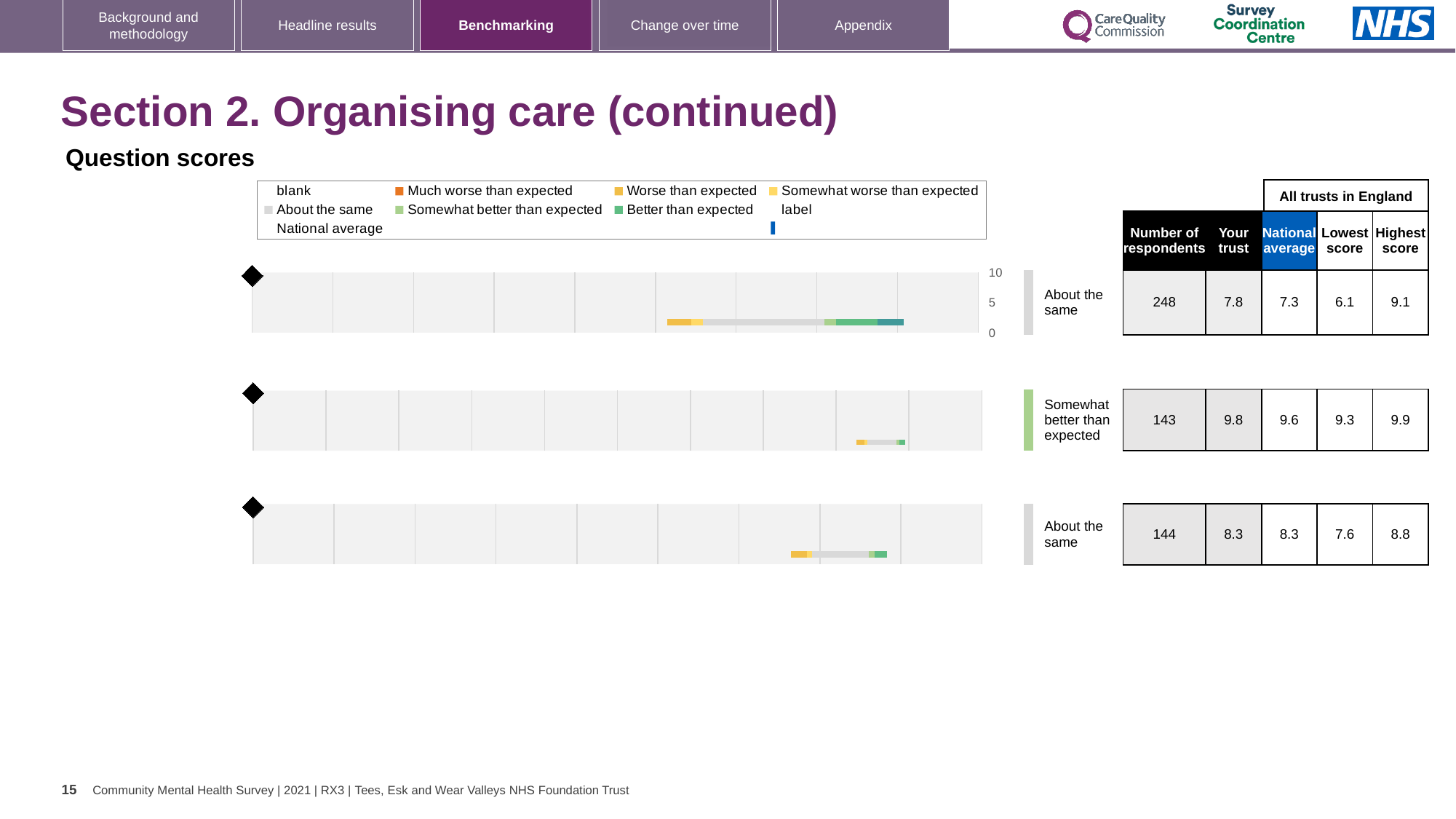
What kind of chart is used on this slide to show the question scores? bar chart What benchmark category label is shown beside the middle chart? Somewhat better than expected How many benchmarking charts are shown on the slide? 3 In the table row beside the top chart, what is the 'Your trust' score? 7.8 In the table row beside the bottom chart, how many respondents are listed? 144 For the bottom chart's row, what is the difference between the highest score and the lowest score? 1.2 In the table row beside the middle chart, what is the national average score? 9.6 For the top chart's row, which is larger: the 'Your trust' score or the national average? Your trust Which chart's row has the highest 'Your trust' score? the middle chart (9.8) What is the highest tick value shown on the axis of the top chart? 10 Which legend entry is shown in orange? Much worse than expected What benchmark category label is shown beside the bottom chart? About the same